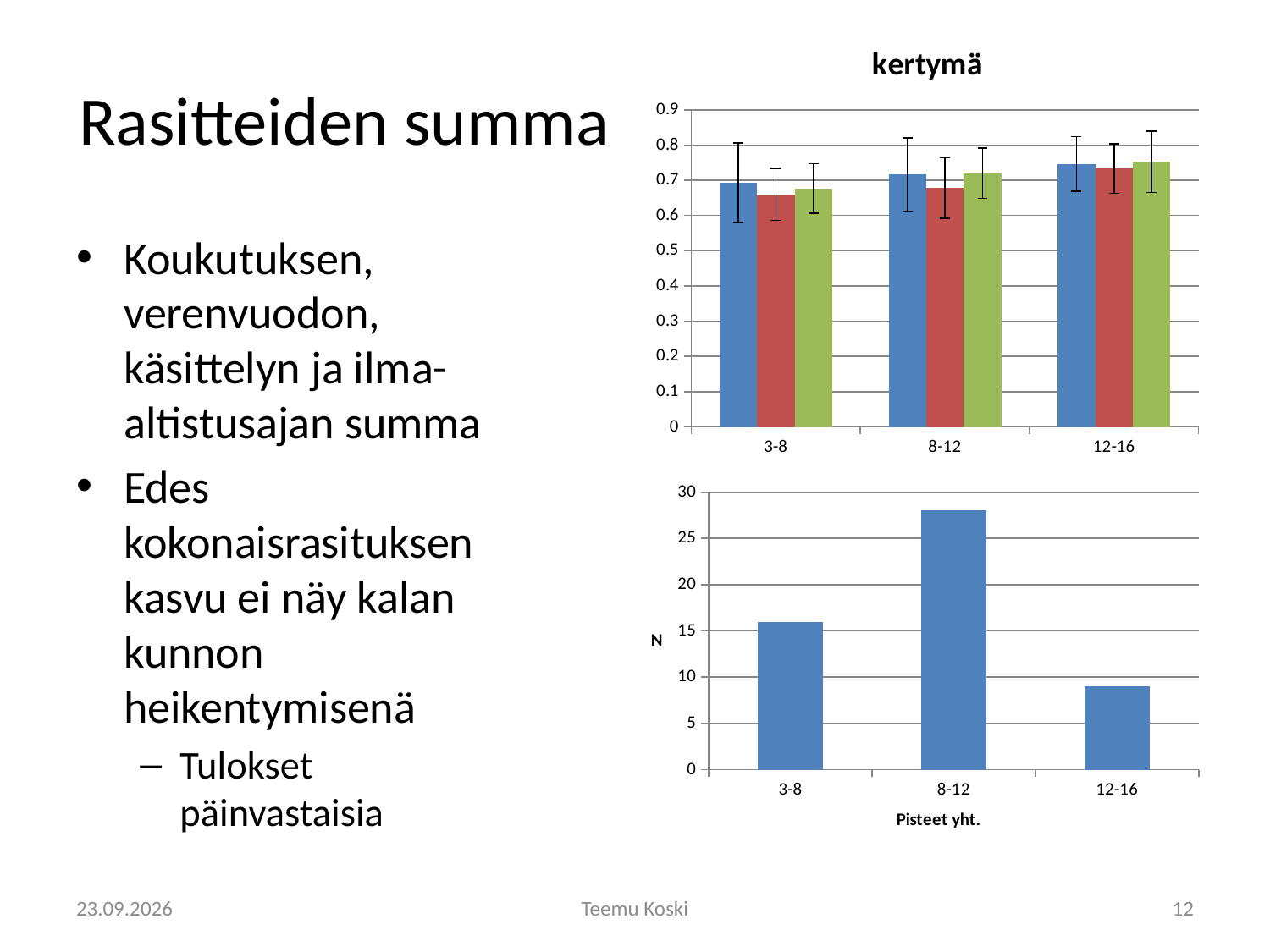
In the bottom chart, which category has the highest value of N? 8-12 In the bottom chart, is the value for 3-8 greater or less than 20? less In the bottom chart, which category has the lowest value of N? 12-16 In the bottom chart, is the value for 8-12 greater or less than 25? greater How many categories are shown on the x axis of the bottom chart? 3 In the bottom chart, which is larger: the value for 3-8 or the value for 12-16? 3-8 What is the x-axis title of the bottom chart? Pisteet yht. In the top chart "kertymä", is the blue bar for 3-8 greater or less than 0.6? greater What type of chart is the bottom chart on the slide? bar chart What is the title of the top chart? kertymä What type of chart is the top chart titled "kertymä"? bar chart